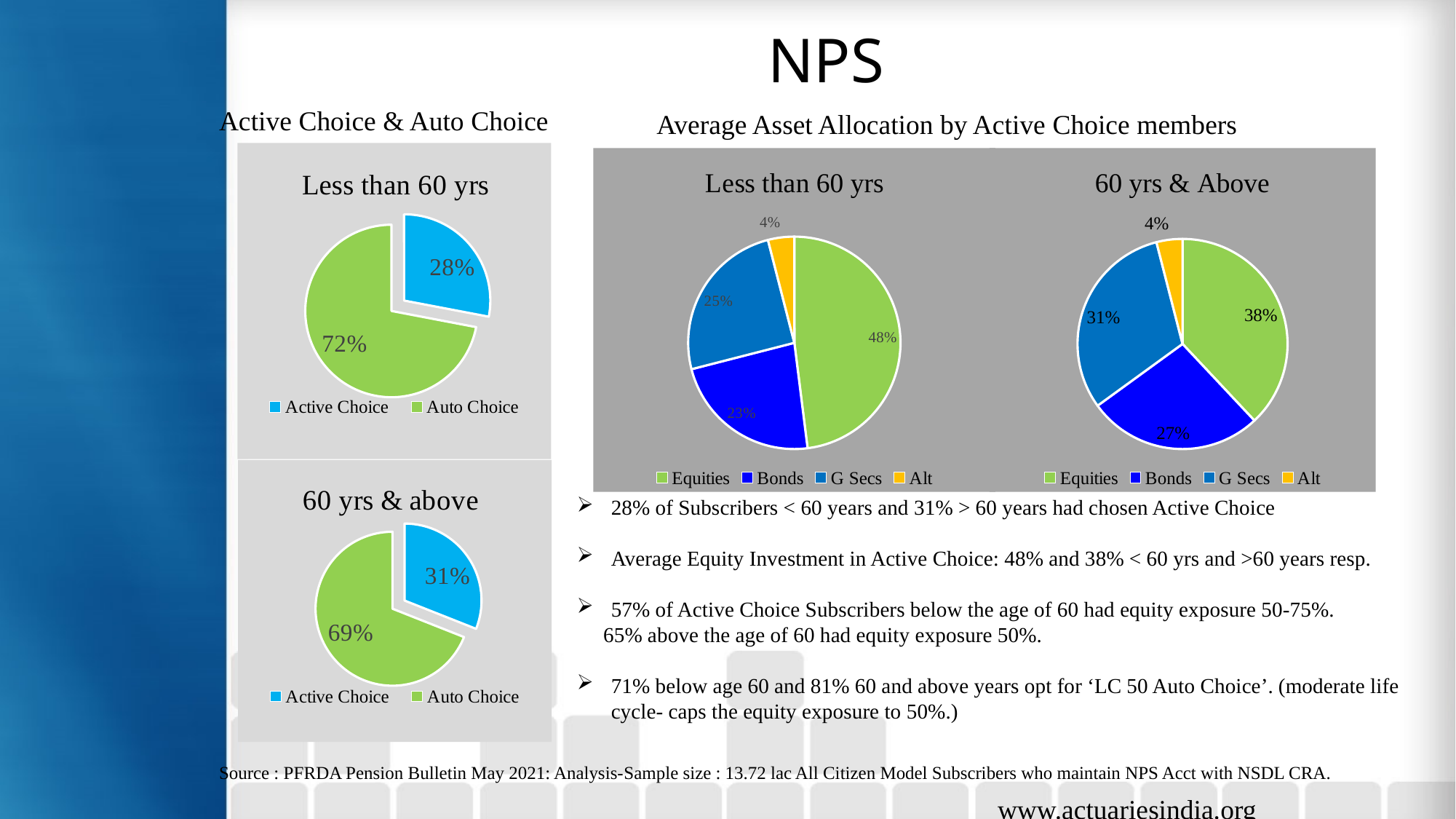
In the '60 yrs & Above' asset allocation pie, which is larger, Bonds or G Secs? G Secs What kind of chart is used for the '60 yrs & above' chart under 'Active Choice & Auto Choice'? Pie chart In the 'Less than 60 yrs' pie under 'Average Asset Allocation by Active Choice members', what is the share for Equities? 48% In the 'Active Choice & Auto Choice' pies, what is the difference between the Active Choice share for 60 yrs & above and for Less than 60 yrs? 3% In the '60 yrs & above' pie under 'Active Choice & Auto Choice', what share is Auto Choice? 69% In the 'Less than 60 yrs' asset allocation pie, what is the difference between the Equities share and the Bonds share? 25% How many categories does the legend list for the 'Less than 60 yrs' asset allocation pie? 4 In the 'Less than 60 yrs' asset allocation pie, which category has the smallest share? Alt In the 'Less than 60 yrs' pie under 'Active Choice & Auto Choice', what share is Active Choice? 28% What colour represents Alt in the asset allocation pie charts? Yellow In the '60 yrs & Above' pie under 'Average Asset Allocation by Active Choice members', what is the share for G Secs? 31% In the '60 yrs & Above' asset allocation pie, which category has the largest share? Equities